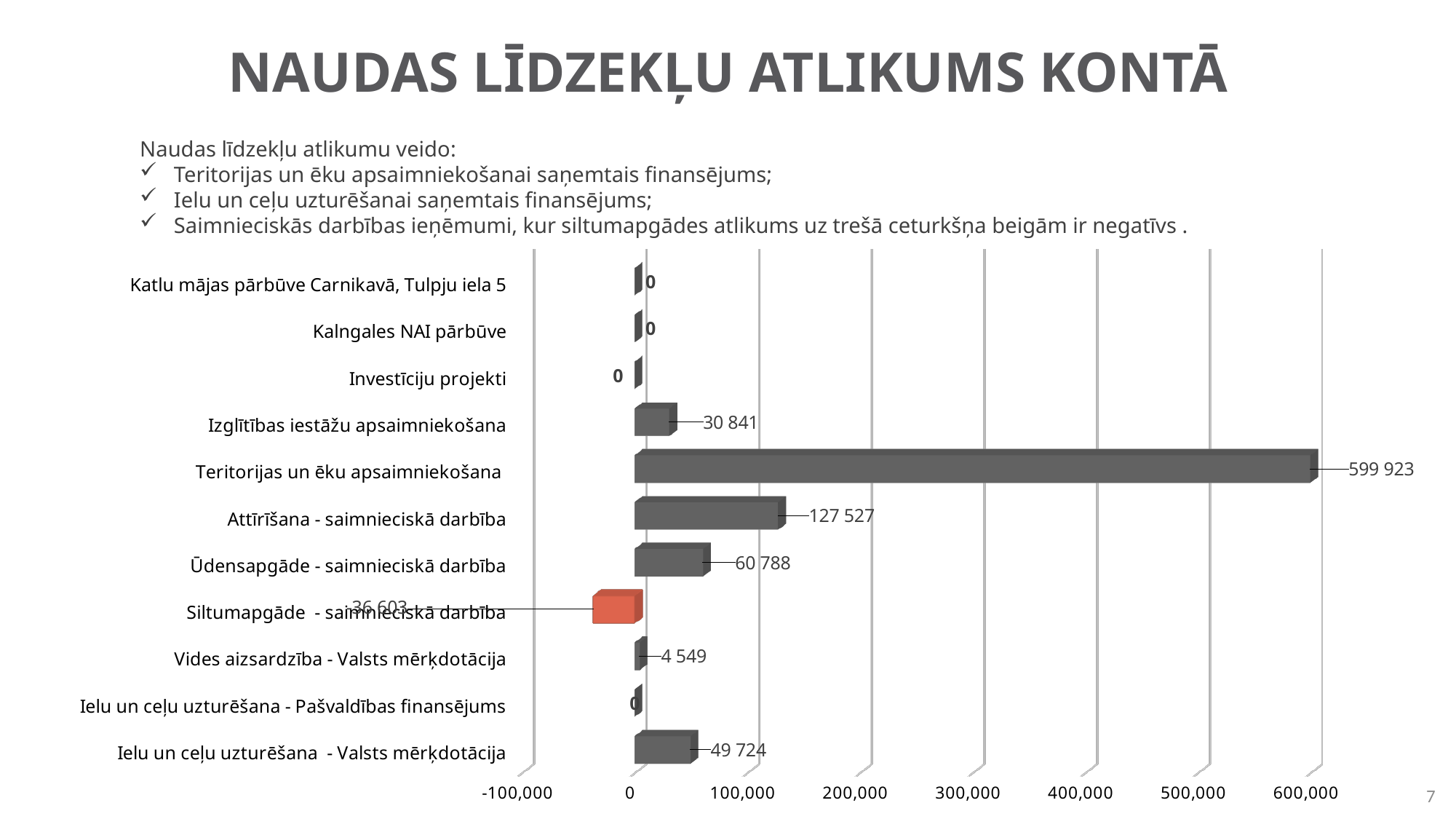
How many categories are plotted in the chart? 11 Which is larger, the value for Ielu un ceļu uzturēšana - Valsts mērķdotācija or the value for Izglītības iestāžu apsaimniekošana? Ielu un ceļu uzturēšana - Valsts mērķdotācija What is the value for Teritorijas un ēku apsaimniekošana? 599 923 What is the value for Ūdensapgāde - saimnieciskā darbība? 60 788 What is the value for Ielu un ceļu uzturēšana - Valsts mērķdotācija? 49 724 Which category has the highest value? Teritorijas un ēku apsaimniekošana What is the difference between the values for Attīrīšana - saimnieciskā darbība and Ūdensapgāde - saimnieciskā darbība? 66 739 Which category has the lowest value? Siltumapgāde - saimnieciskā darbība What kind of chart is shown on the slide? bar chart What is the value for Attīrīšana - saimnieciskā darbība? 127 527 What is the value for Izglītības iestāžu apsaimniekošana? 30 841 What is the value for Vides aizsardzība - Valsts mērķdotācija? 4 549